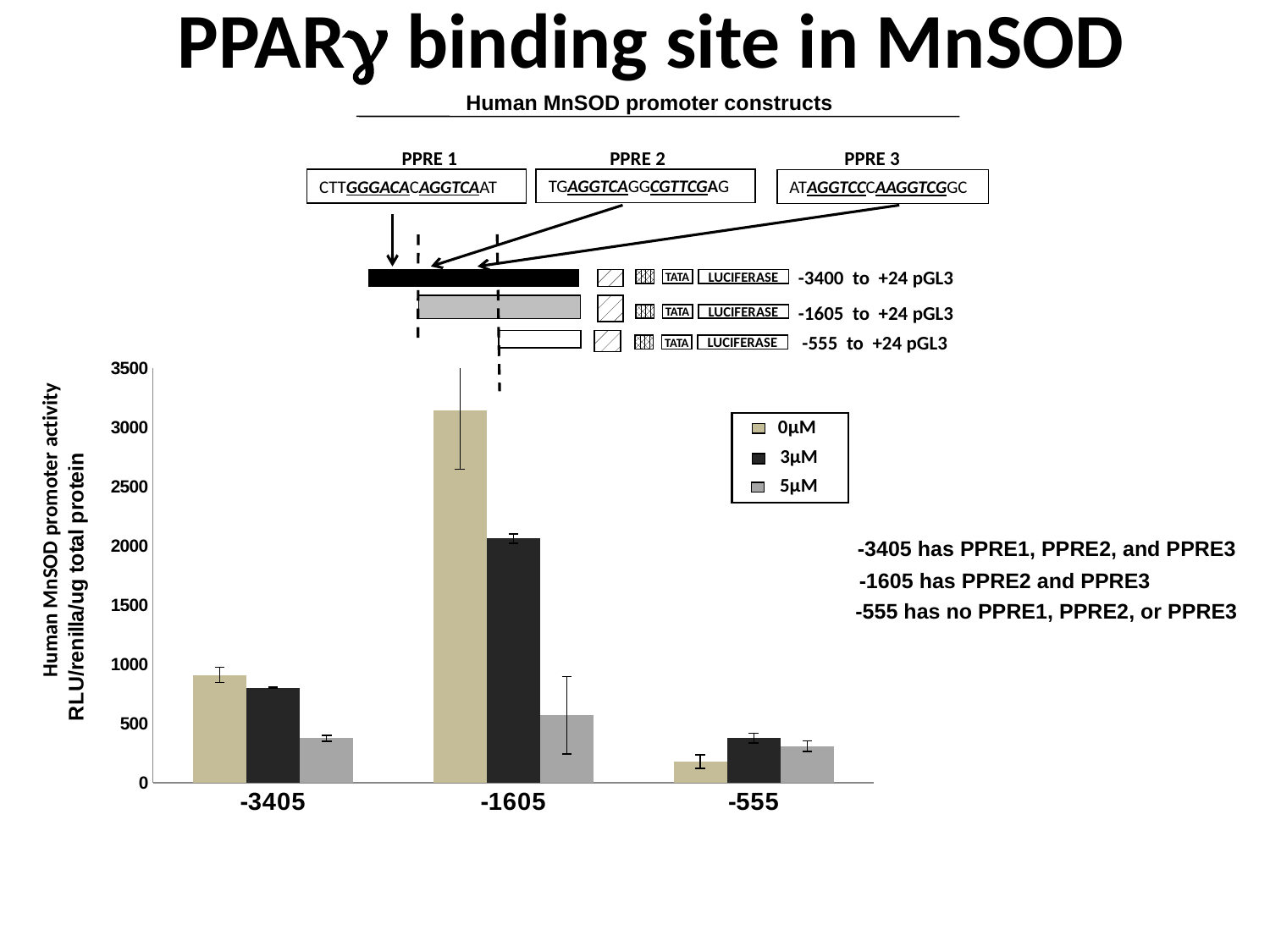
How many series does the chart legend list? 3 Is the 3µM value for -1605 greater or less than 2500? less Which construct has the highest 0µM bar? -1605 For the -1605 construct, which is larger, the 0µM bar or the 5µM bar? 0µM How many promoter construct categories are shown on the x axis of the chart? 3 What kind of chart is shown on the slide? bar chart Which construct has the lowest 0µM bar? -555 For the -555 construct, which is larger, the 0µM bar or the 3µM bar? 3µM What are the three legend entries of the chart? 0µM, 3µM, 5µM Is the 0µM value for -1605 greater or less than 3000? greater Is the 0µM value for -3405 greater or less than 500? greater